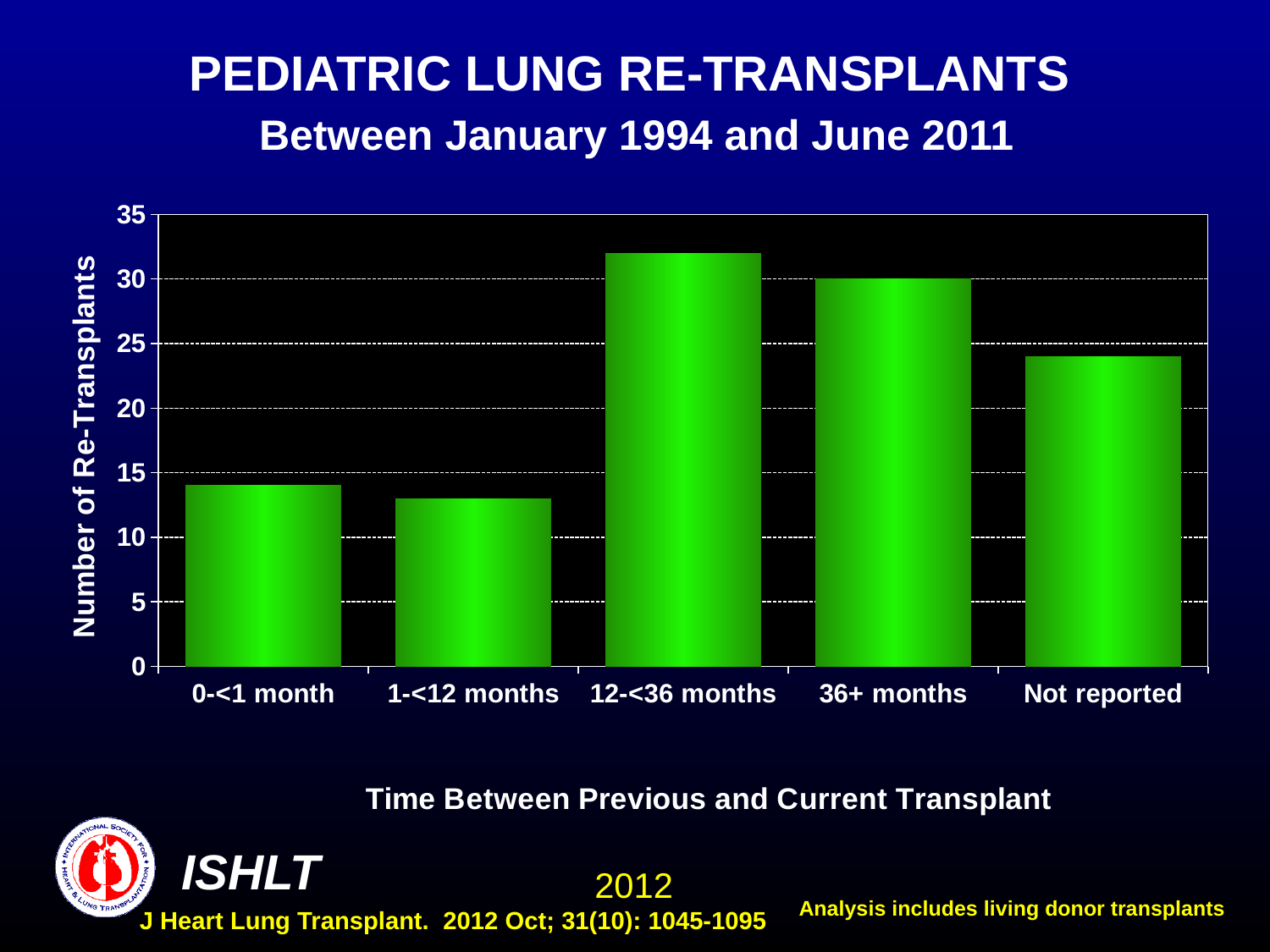
Which is larger, the value for 36+ months or the value for 0-<1 month? 36+ months Is the value for 36+ months greater or less than 25? greater How many categories are shown on the x axis of the chart? 5 Which category has the highest number of re-transplants? 12-<36 months Is the value for 1-<12 months greater or less than 10? greater Is the value for 12-<36 months greater or less than 30? greater What is the label of the y axis? Number of Re-Transplants What is the label of the x axis? Time Between Previous and Current Transplant Which is larger, the value for 12-<36 months or the value for Not reported? 12-<36 months What kind of chart is shown on the slide? bar chart